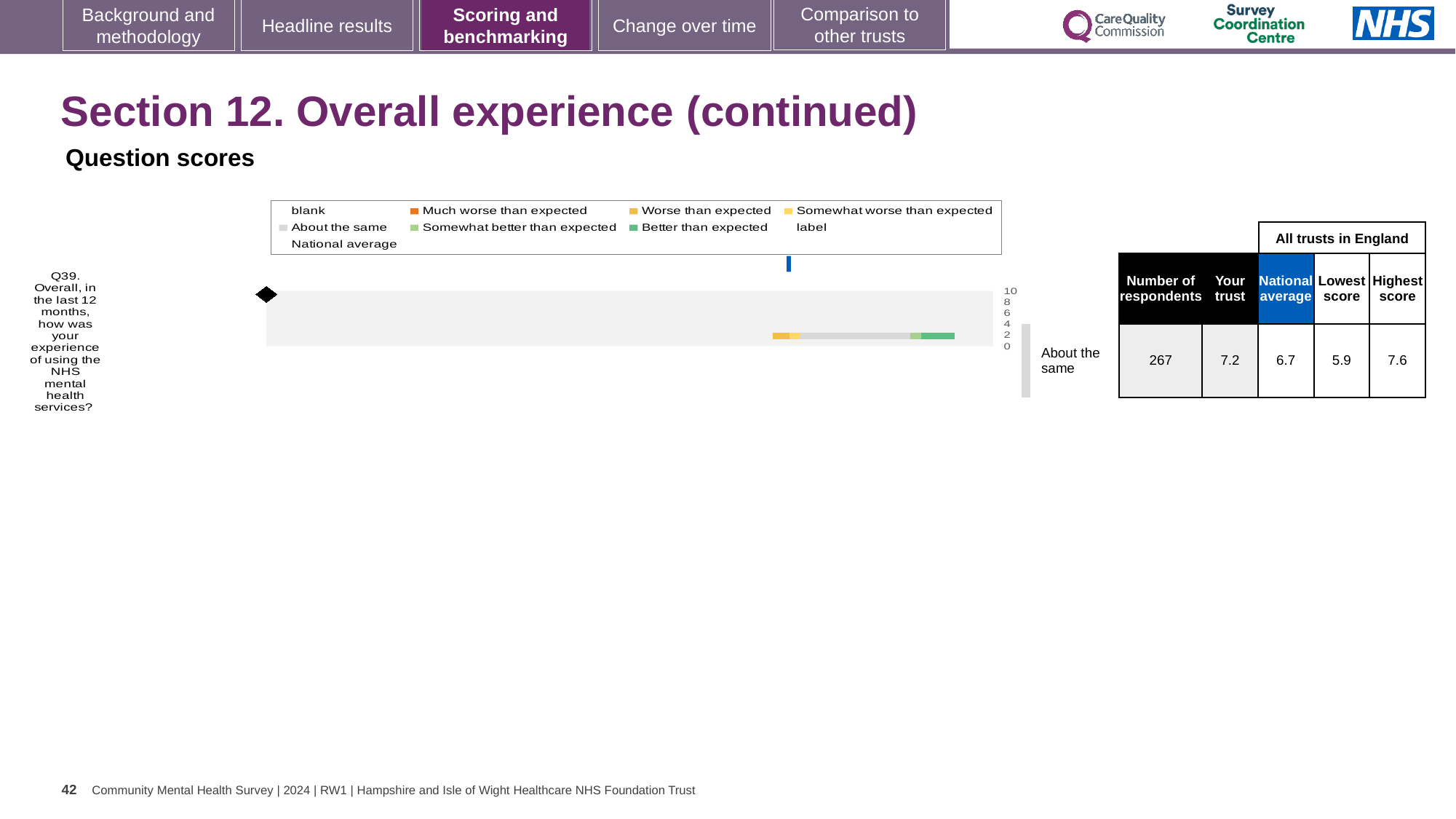
What is the 'Your trust' score for Q39? 7.2 How many respondents answered Q39? 267 What is the lowest score among all trusts in England for Q39? 5.9 What kind of chart is shown on the slide for Q39? bar chart What is the highest score among all trusts in England for Q39? 7.6 Which survey question is plotted in the chart? Q39. Overall, in the last 12 months, how was your experience of using the NHS mental health services? What is the difference between the highest and lowest scores for Q39 across all trusts in England? 1.7 What is the national average score for Q39? 6.7 Which is larger for Q39: the 'Your trust' score or the national average? Your trust By how much does the 'Your trust' score for Q39 exceed the national average? 0.5 What benchmark category is the trust's Q39 result labelled as on the chart? About the same What colour does the legend use for 'Better than expected'? green